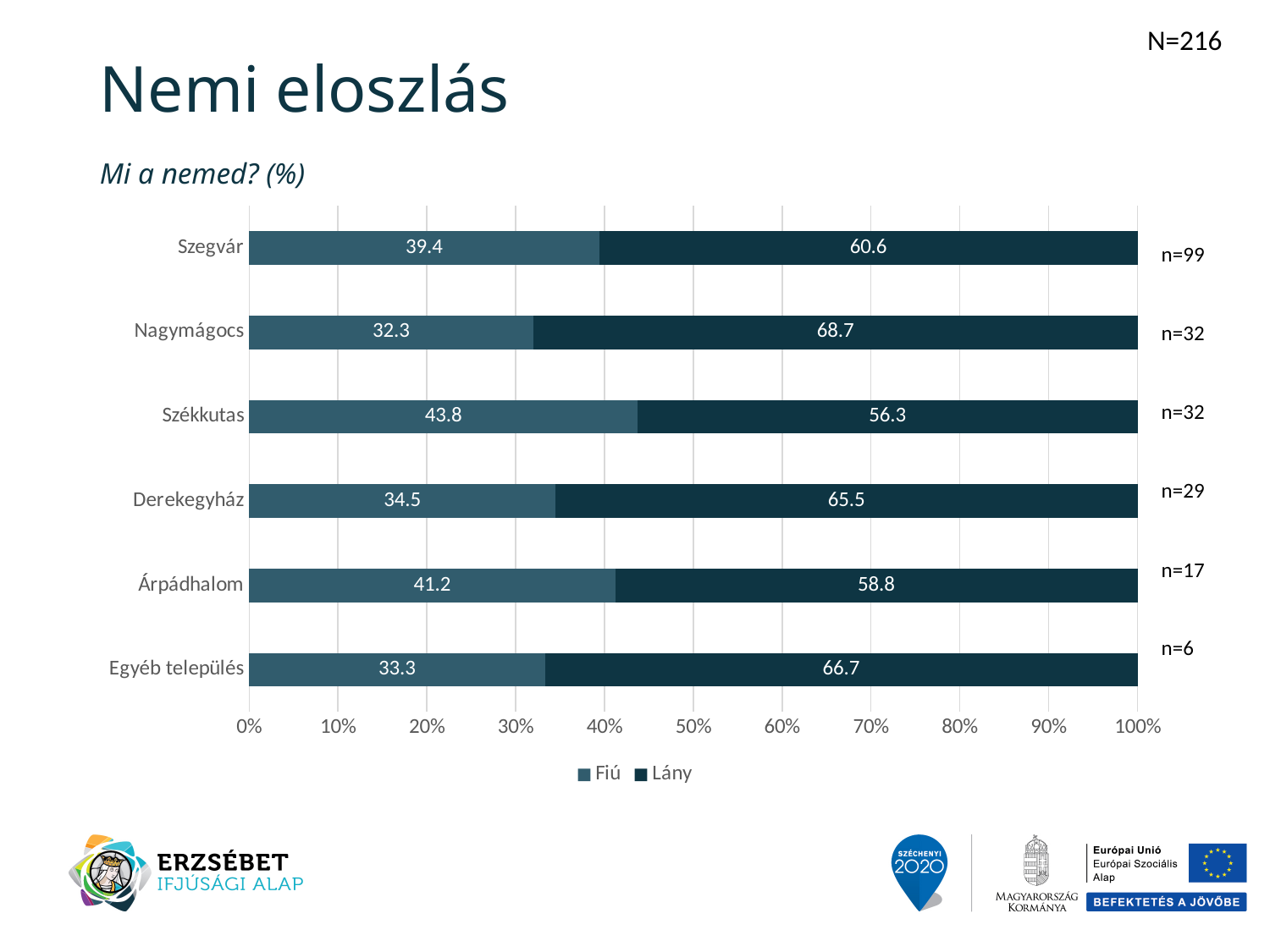
How many series does the legend list? 2 What is the difference between the Lány and Fiú values for Derekegyház? 31 Which category has the highest Fiú value? Székkutas Which category has the highest Lány value? Nagymágocs What is the Fiú value for Székkutas? 43.8 What is the Lány value for Árpádhalom? 58.8 What is the Lány value for Nagymágocs? 68.7 Which category has the lowest Fiú value? Nagymágocs What is the Fiú value for Szegvár? 39.4 Is the Fiú value for Egyéb település larger or the Fiú value for Árpádhalom? Árpádhalom How many categories are shown on the chart? 6 What kind of chart is shown on the slide? Stacked bar chart